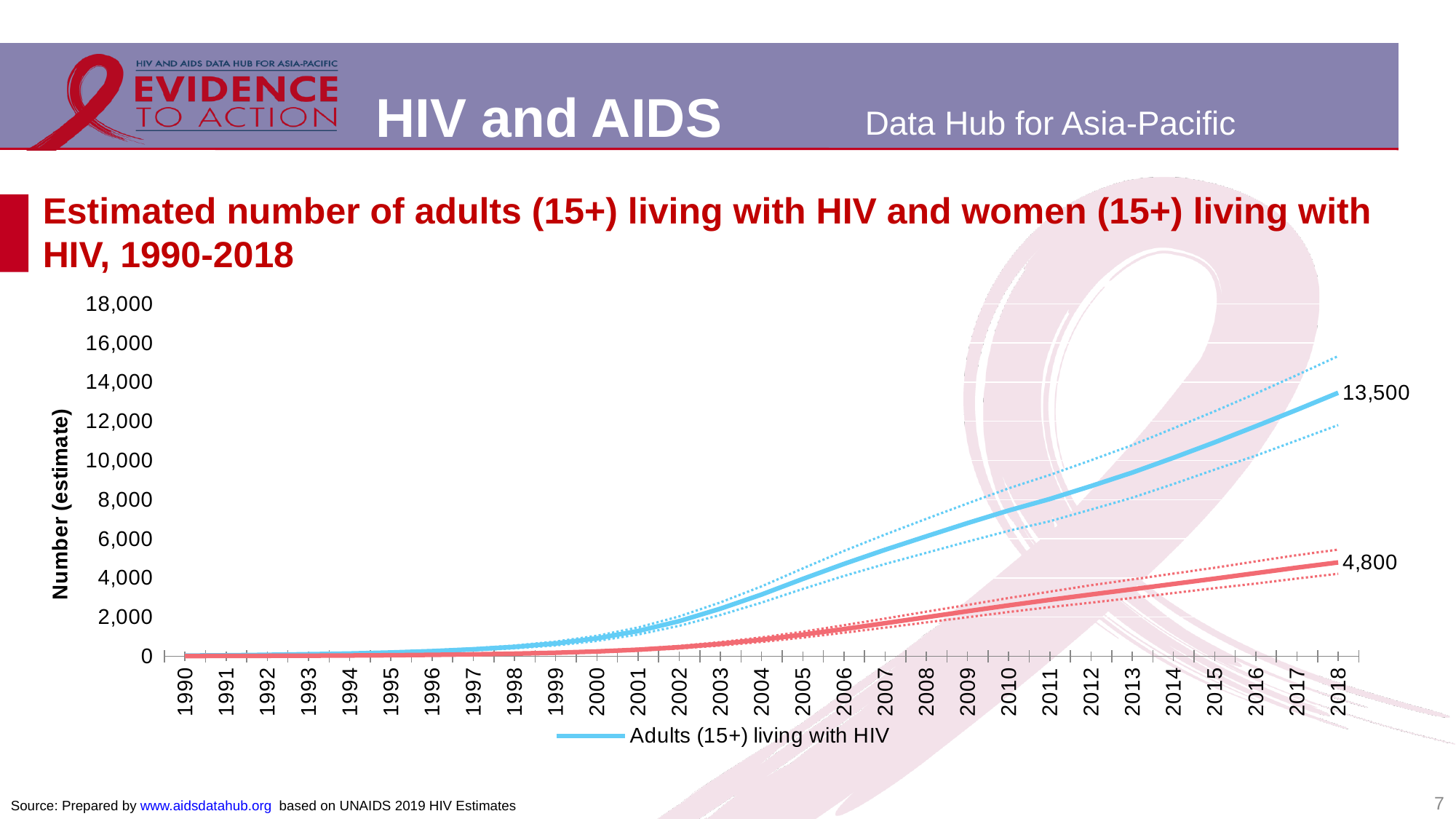
In 2018, which line has the larger value: the blue Adults (15+) living with HIV line or the red line? Adults (15+) living with HIV (blue) What kind of chart is shown on the slide? Line chart Do the values for Adults (15+) living with HIV rise or fall from 1990 to 2018? Rise How many series does the legend list? 1 In which year does the Adults (15+) living with HIV line reach its highest value? 2018 What is the title of the y axis? Number (estimate) What is the labelled 2018 value on the red (lower) line? 4,800 What is the labelled value for Adults (15+) living with HIV in 2018? 13,500 Is the value for Adults (15+) living with HIV in 2010 greater or less than 6,000? greater How many years are shown on the x axis? 29 Is the value for Adults (15+) living with HIV in 2000 greater or less than 2,000? less What is the difference between the two labelled 2018 values, 13,500 and 4,800? 8,700